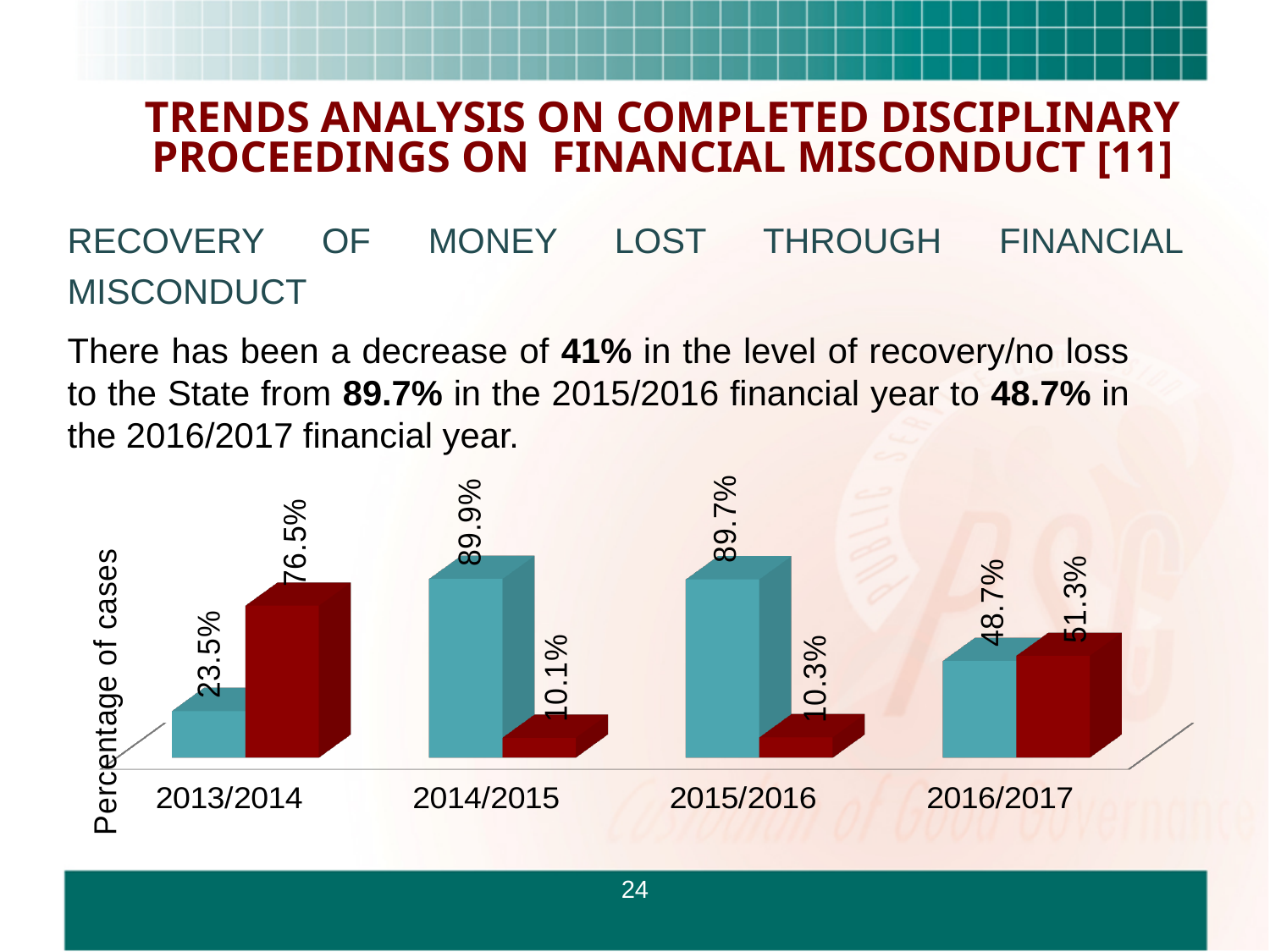
How many financial years are shown on the x axis? 4 What is the label on the vertical axis of the chart? Percentage of cases What is the value of the red bar for 2016/2017? 51.3% What is the value of the blue bar for 2013/2014? 23.5% What is the difference between the blue bar values for 2015/2016 and 2016/2017? 41% What kind of chart is shown on the slide? bar chart What is the value of the blue bar for 2015/2016? 89.7% In which financial year is the blue bar lowest? 2013/2014 What is the value of the red bar for 2014/2015? 10.1% What is the value of the red bar for 2013/2014? 76.5% In which financial year is the red bar highest? 2013/2014 For 2016/2017, which bar is larger, the blue bar or the red bar? the red bar